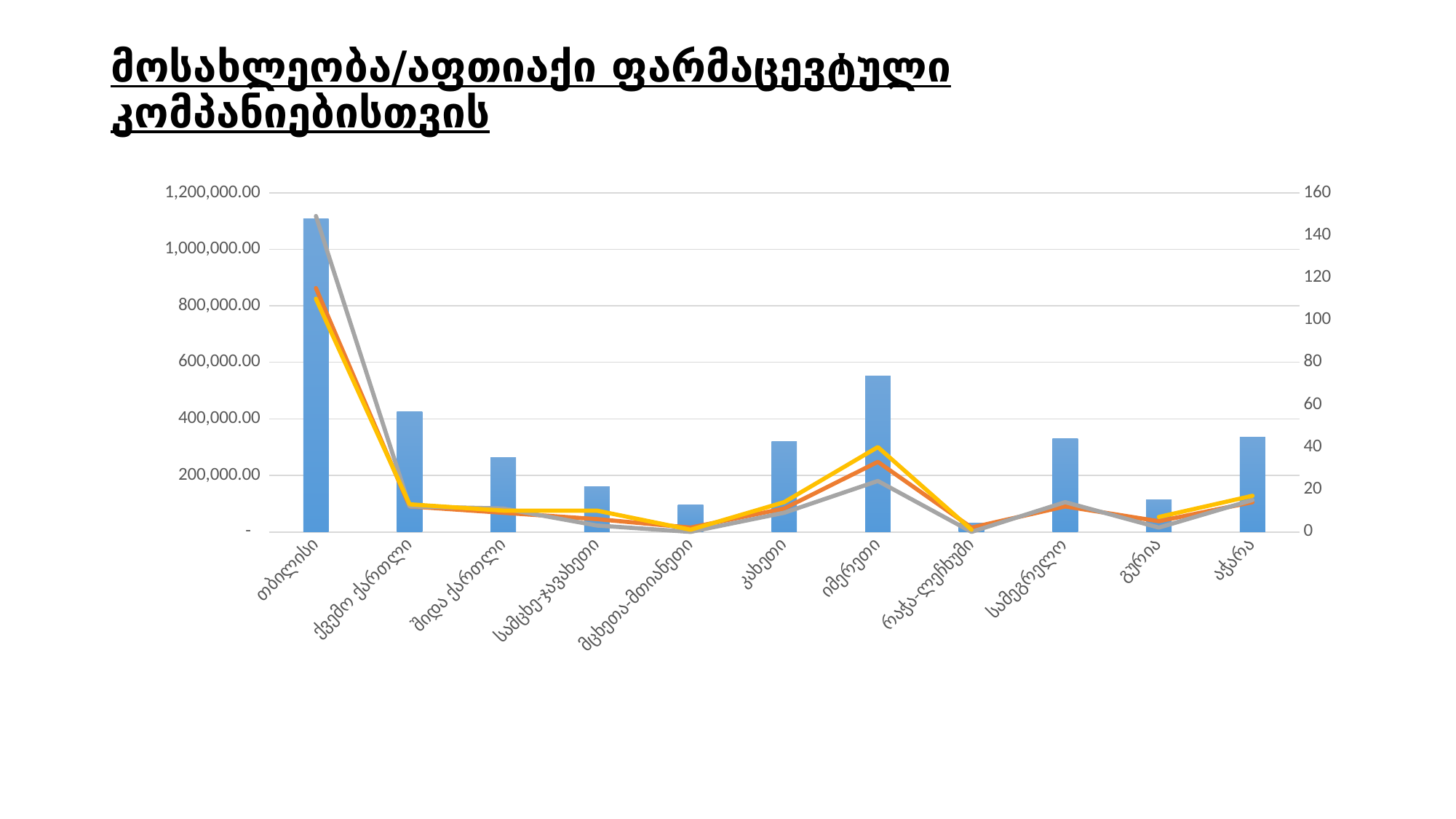
Which category has the tallest bar? თბილისი Is the bar value for იმერეთი greater or less than 400,000.00? greater Which category has the shortest bar? რაჭა-ლეჩხუმი Is the bar value for თბილისი greater or less than 1,000,000.00? greater How many categories are shown along the x axis? 11 Which has the larger bar, იმერეთი or კახეთი? იმერეთი What kind of chart is shown on the slide? A combined bar and line chart Which has the larger bar, სამეგრელო or გურია? სამეგრელო How many line series are plotted on the chart? 3 Is the bar value for მცხეთა-მთიანეთი greater or less than 200,000.00? less Do the line values rise or fall from თბილისი to ქვემო ქართლი? fall